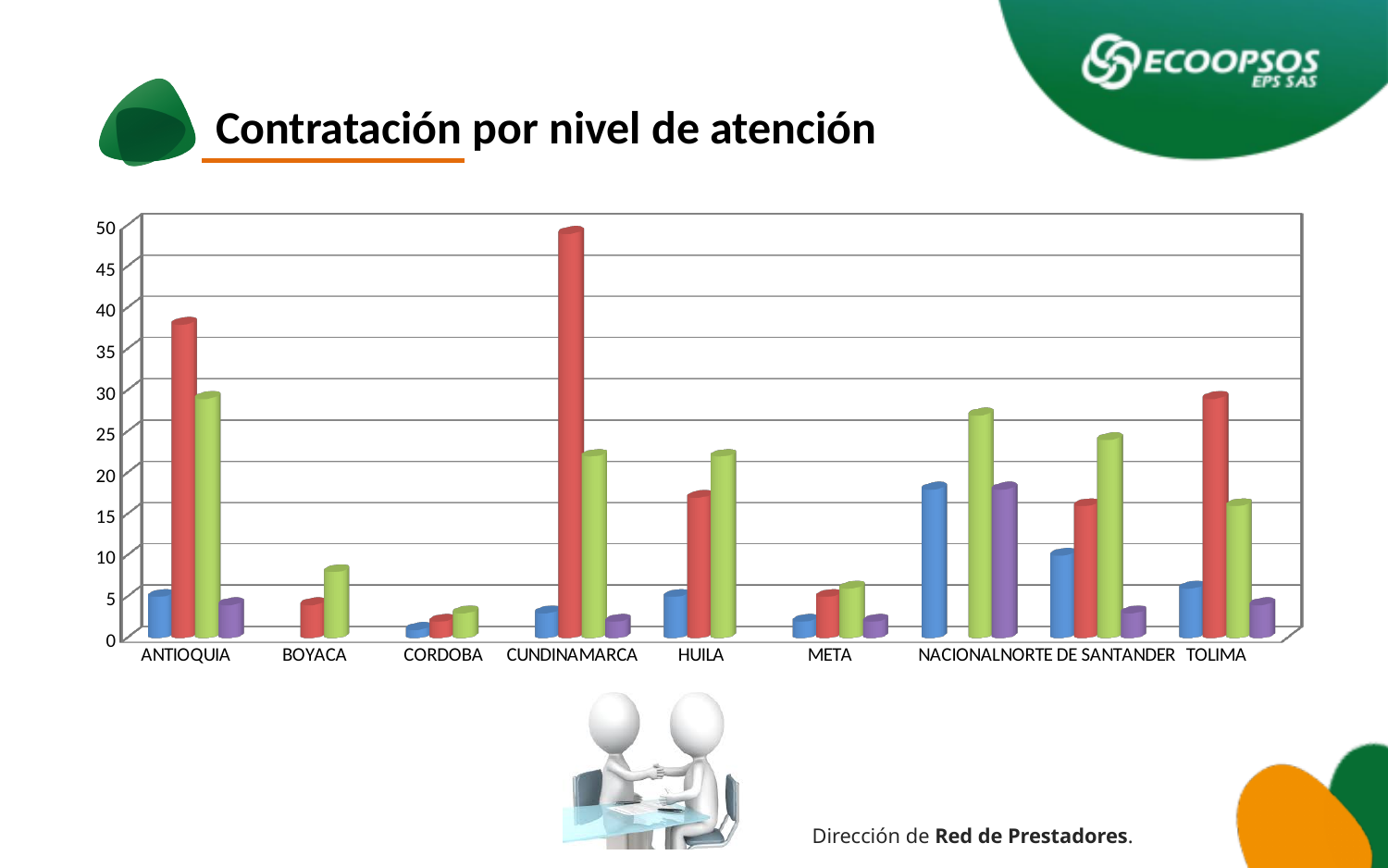
Which category has the smallest bars overall? CORDOBA How many categories are shown along the x axis of the chart? 9 What kind of chart is shown on the slide? bar chart What is the title of the slide containing the chart? Contratación por nivel de atención Is the red bar for ANTIOQUIA greater or less than 35? greater Is the red bar for CUNDINAMARCA greater or less than 45? greater How many different bar colours (series) appear in the chart? 4 Which is larger, the red bar for ANTIOQUIA or the red bar for TOLIMA? ANTIOQUIA Is the green bar for BOYACA greater or less than 10? less Which category has the tallest bar in the whole chart? CUNDINAMARCA Which category has the tallest blue bar? NACIONAL